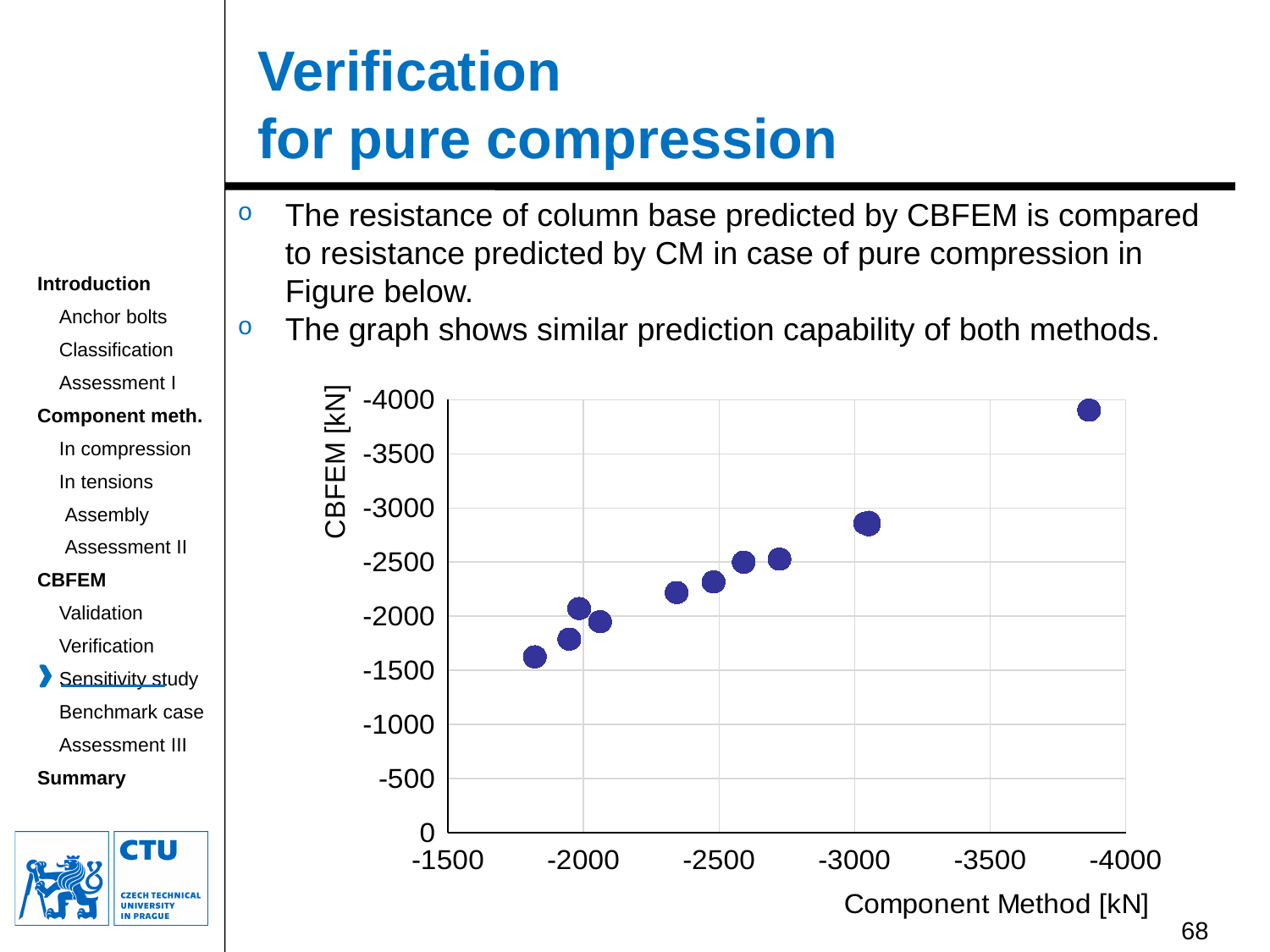
As the Component Method values move from -1500 toward -4000 along the x axis, do the CBFEM values become more negative or less negative? More negative How many data points have a CBFEM value beyond (more negative than) -3000 kN? 1 How many data points have a CBFEM value between 0 and -1000 kN? 0 What is the title of the vertical axis of the chart? CBFEM [kN] How many data points are plotted in the chart? 10 What is the last tick value shown on the horizontal axis of the chart? -4000 What is the title of the horizontal axis of the chart? Component Method [kN] What kind of chart is shown on the slide? Scatter chart